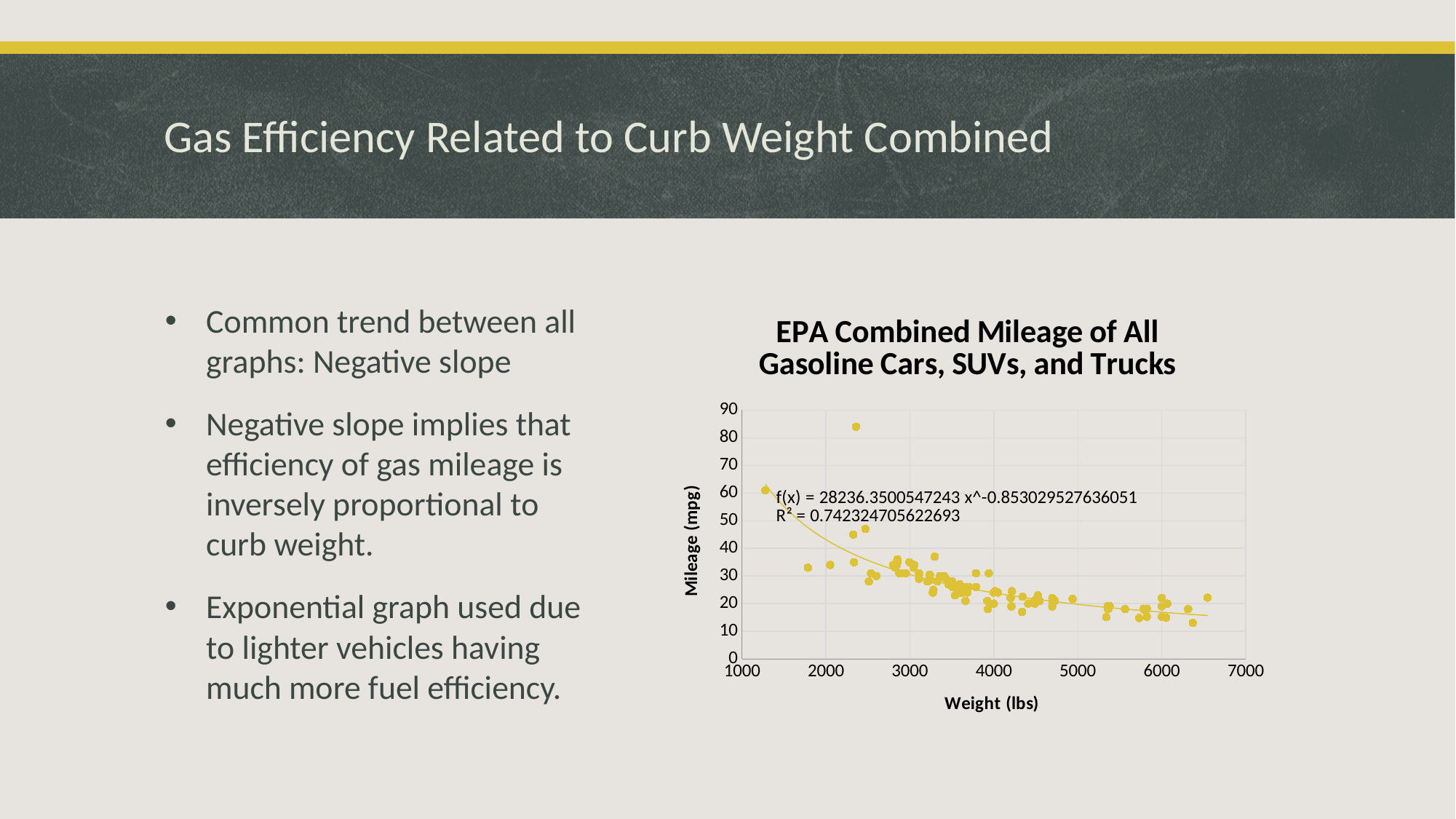
Is the mileage of the leftmost point (near 1300 lbs) greater or less than 50? greater What is the maximum value shown on the y axis of the chart? 90 Is the mileage of the points near 6000 lbs greater or less than 30? less What R² value is printed on the chart? R² = 0.742324705622693 What is the label of the x axis of the chart? Weight (lbs) What is the title of the chart? EPA Combined Mileage of All Gasoline Cars, SUVs, and Trucks What is the coefficient in the trendline equation f(x) printed on the chart? 28236.3500547243 As weight increases along the x axis, does mileage generally rise or fall? fall What kind of chart is shown on the slide? scatter chart What is the exponent of x in the trendline equation printed on the chart? -0.853029527636051 What is the maximum value shown on the x axis of the chart? 7000 Is the mileage of the highest point on the chart greater or less than 80? greater